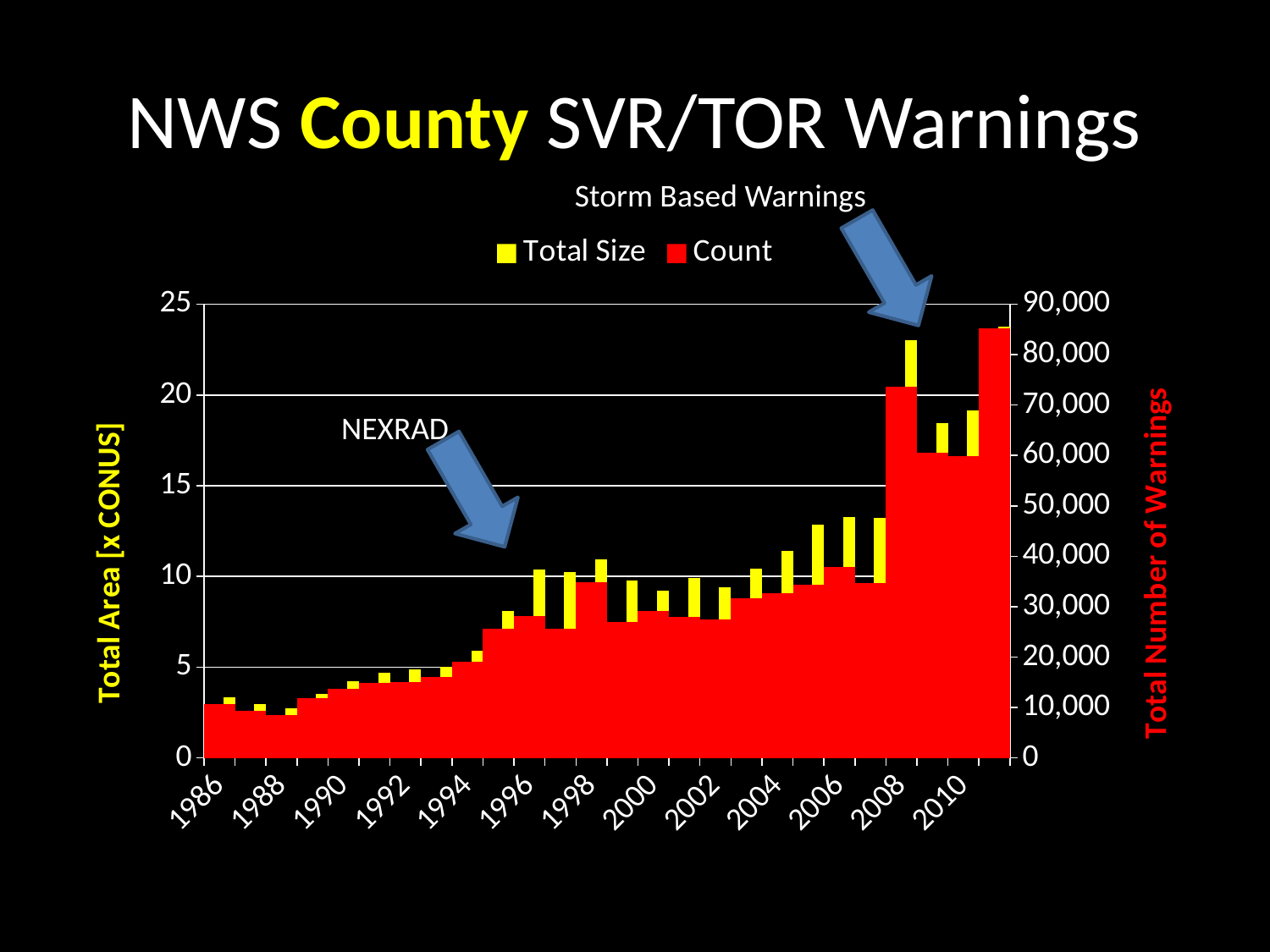
Is the Total Size value for 2009 greater or less than 20? less What are the two series named in the chart legend? Total Size and Count How many series does the chart legend list? 2 Overall, does the Count of warnings rise or fall from 1986 to 2011? rise Which year has the larger Count of warnings, 2007 or 2008? 2008 Is the Count value for 2011 greater or less than 80,000? greater Which year has the highest Count of warnings? 2011 Which year has the lowest Count of warnings? 1988 What kind of chart is used to plot the Total Size series? bar chart What is the title of the left vertical axis? Total Area [x CONUS] Is the Count value for 1986 greater or less than 20,000? less